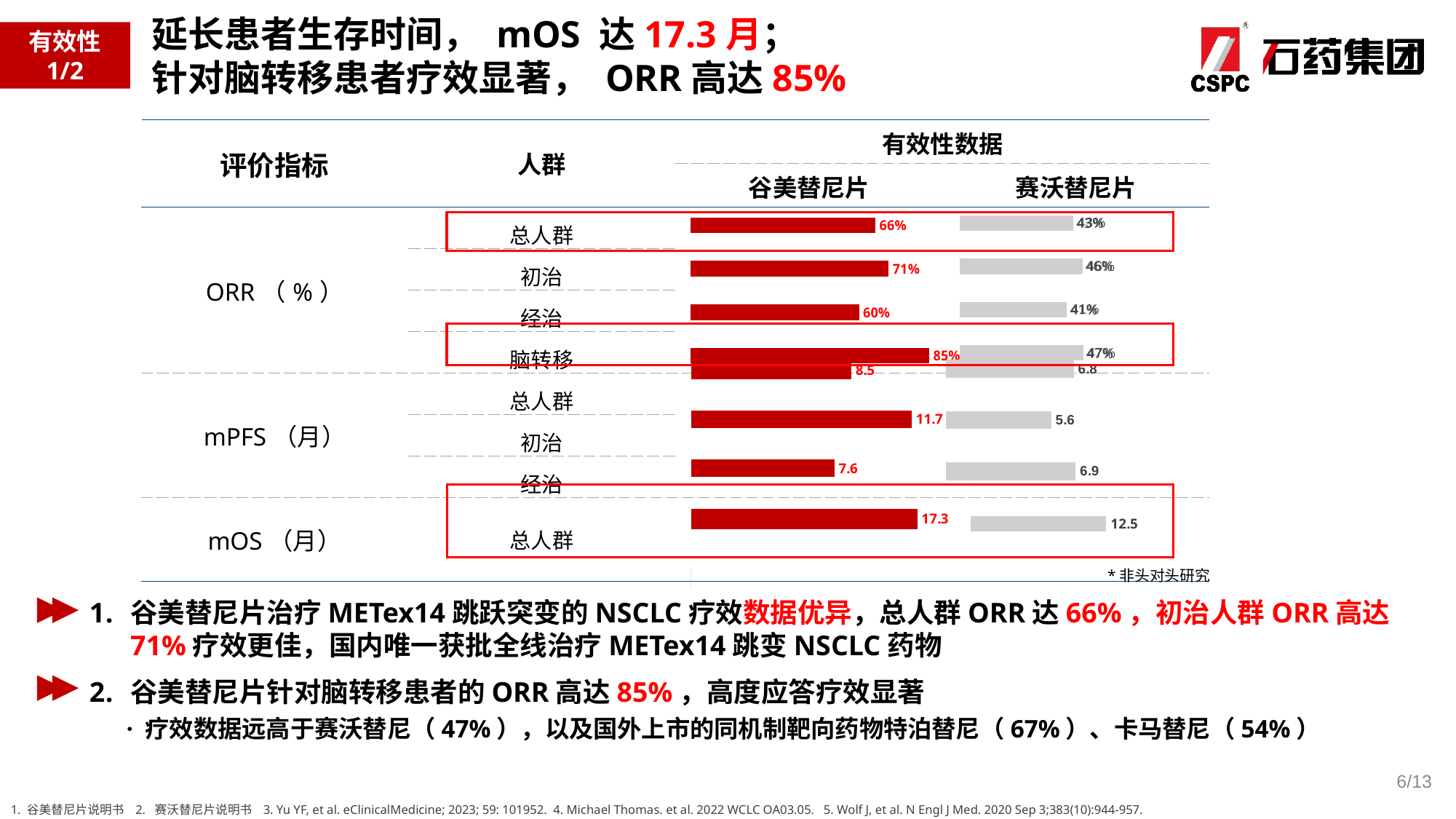
What is the ORR for 赛沃替尼片 in the 脑转移 group? 47% In the 初治 group, which drug has the higher mPFS (月), 谷美替尼片 or 赛沃替尼片? 谷美替尼片 Among the ORR rows, which population group has the lowest value for 赛沃替尼片? 经治 What is the difference between the ORR of 谷美替尼片 and 赛沃替尼片 in the 脑转移 group? 38% How many population rows are shown under the ORR (%) indicator? 4 What type of chart is used to display the efficacy data in the table? Bar chart What is the difference in mOS (月) between 谷美替尼片 and 赛沃替尼片 in the 总人群 group? 4.8 What is the ORR for 谷美替尼片 in the 总人群 group? 66% What colour are the bars for 谷美替尼片? Red What is the mOS (月) for 谷美替尼片 in the 总人群 group? 17.3 Among the ORR rows, which population group has the highest value for 谷美替尼片? 脑转移 What is the mPFS (月) for 赛沃替尼片 in the 初治 group? 5.6